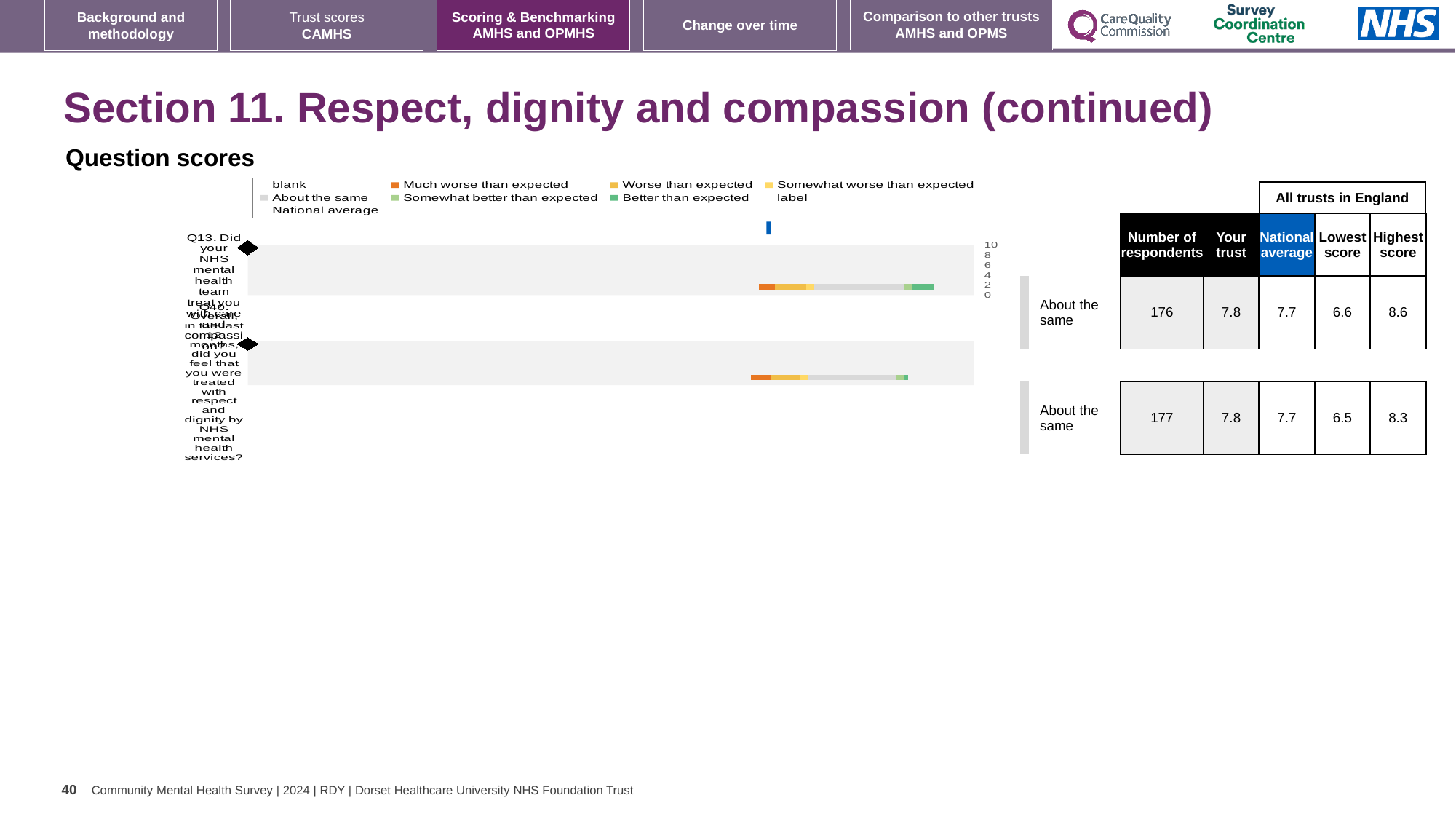
What is the highest score across all trusts in England for Q13? 8.6 How many entries does the legend of the question scores chart list? 9 What is the 'Your trust' score for Q10? 7.8 What is the difference between the highest score and the lowest score for Q13? 2.0 What is the national average score for Q13? 7.7 What type of chart is used to show the question scores on this slide? bar chart What is the lowest score across all trusts in England for Q10? 6.5 How many questions are plotted in the question scores chart? 2 Which is larger for Q10: the 'Your trust' score or the national average? Your trust Which legend entry in the question scores chart is shown in orange? Much worse than expected How many respondents are shown for Q13 in the table next to the chart? 176 Which benchmark category is shown for Q13 in the question scores chart? About the same